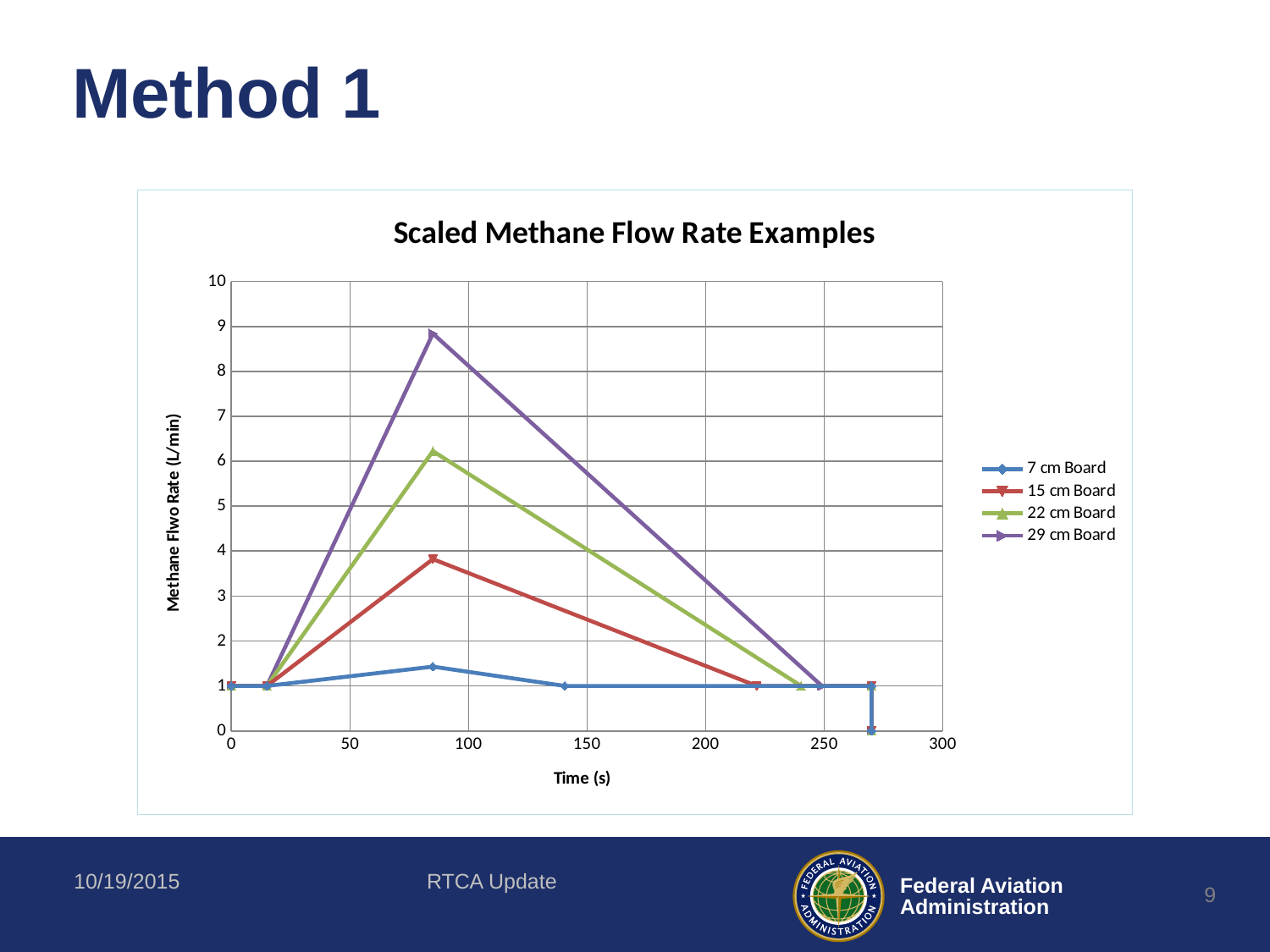
After reaching its peak, does the 29 cm Board series rise or fall as time increases? fall What kind of chart is shown on the slide? line chart What is the title of the chart? Scaled Methane Flow Rate Examples Which series reaches the highest peak methane flow rate? 29 cm Board Is the peak value for the 29 cm Board series greater or less than 8? greater Is the peak value for the 22 cm Board series greater or less than 7? less Which series has the lowest peak methane flow rate? 7 cm Board How many series does the legend list? 4 Is the peak value for the 7 cm Board series greater or less than 2? less What is the label of the x axis? Time (s) Which series has a higher peak flow rate, 15 cm Board or 22 cm Board? 22 cm Board